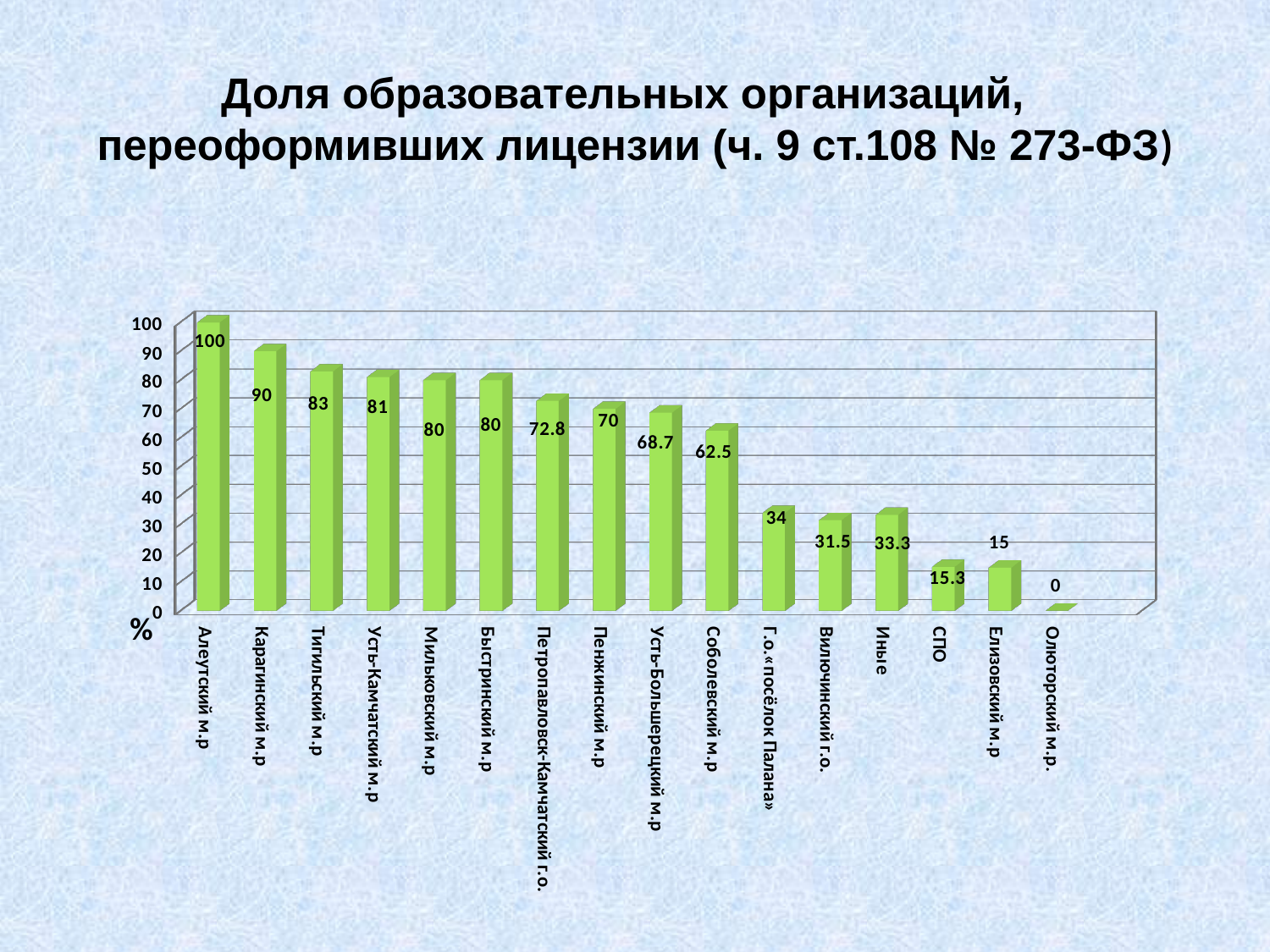
Which is larger, the value for Вилючинский г.о. or the value for Иные? Иные How many categories are shown on the chart? 16 What is the value for СПО? 15.3 What unit is indicated on the vertical axis of the chart? % What is the value for Петропавловск-Камчатский г.о.? 72.8 Is the value for Г.о.«посёлок Палана» greater or less than 50? less Which category has the highest value? Алеутский м.р What is the value for Усть-Большерецкий м.р? 68.7 Which category has the lowest value? Олюторский м.р. What is the value for Алеутский м.р? 100 What kind of chart is shown on the slide? bar chart What is the difference between the values for Карагинский м.р and Соболевский м.р? 27.5